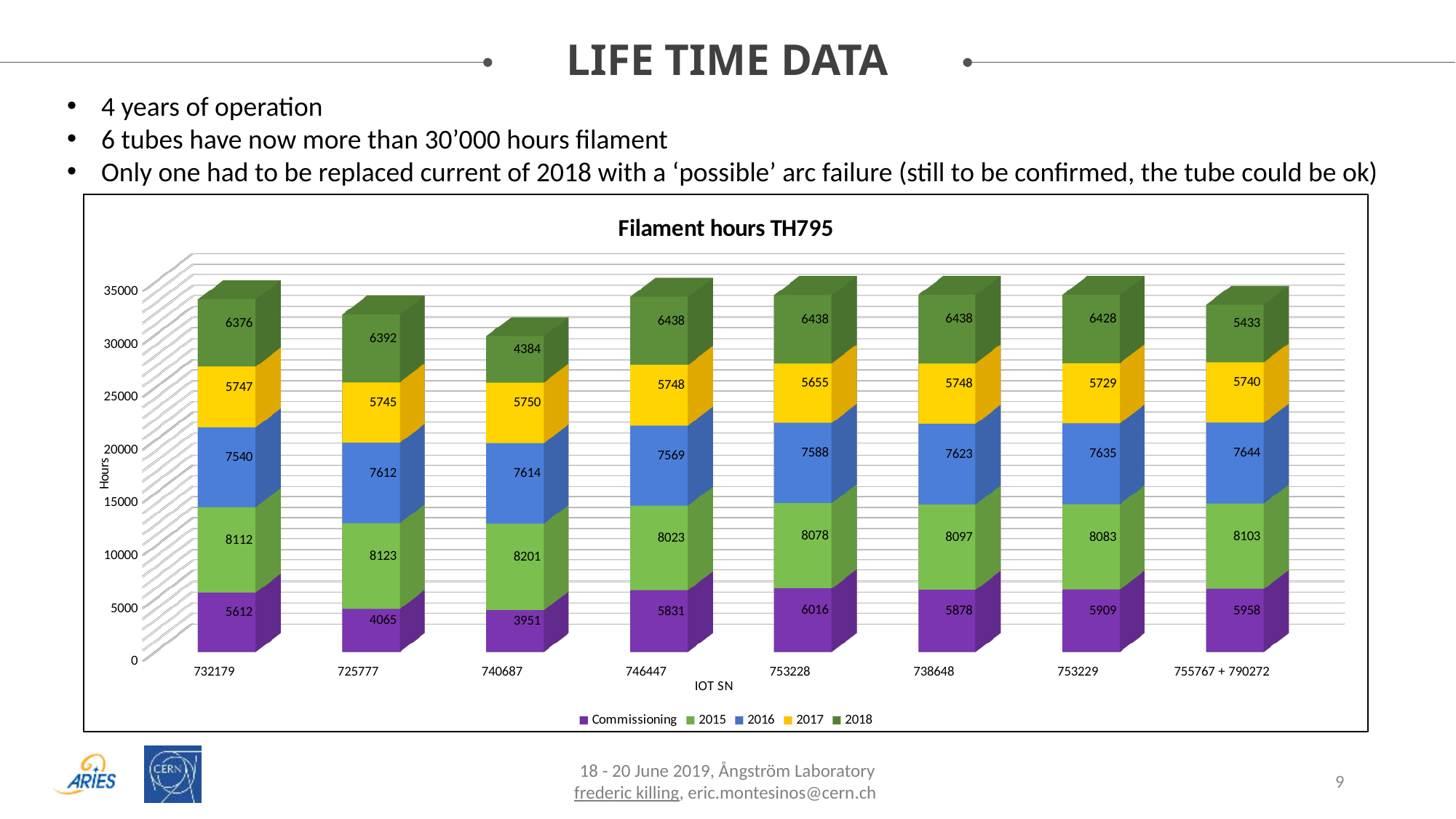
In the Filament hours TH795 chart, what is the 2018 value for tube 740687? 4384 In the Filament hours TH795 chart, what is the Commissioning value for tube 753228? 6016 Which IOT SN has the lowest Commissioning value in the Filament hours TH795 chart? 740687 In the Filament hours TH795 chart, what is the 2017 value for tube 753228? 5655 In the Filament hours TH795 chart, which has the larger Commissioning value, 732179 or 725777? 732179 What is the total filament hours for tube 740687 in the Filament hours TH795 chart? 29900 How many series does the legend of the Filament hours TH795 chart list? 5 In the Filament hours TH795 chart, what is the difference between the 2018 value for 732179 and the 2018 value for 740687? 1992 Which IOT SN has the highest 2015 value in the Filament hours TH795 chart? 740687 What kind of chart is the Filament hours TH795 chart? Stacked bar chart How many IOT SN categories are shown on the x axis of the Filament hours TH795 chart? 8 What is the label of the x axis in the Filament hours TH795 chart? IOT SN